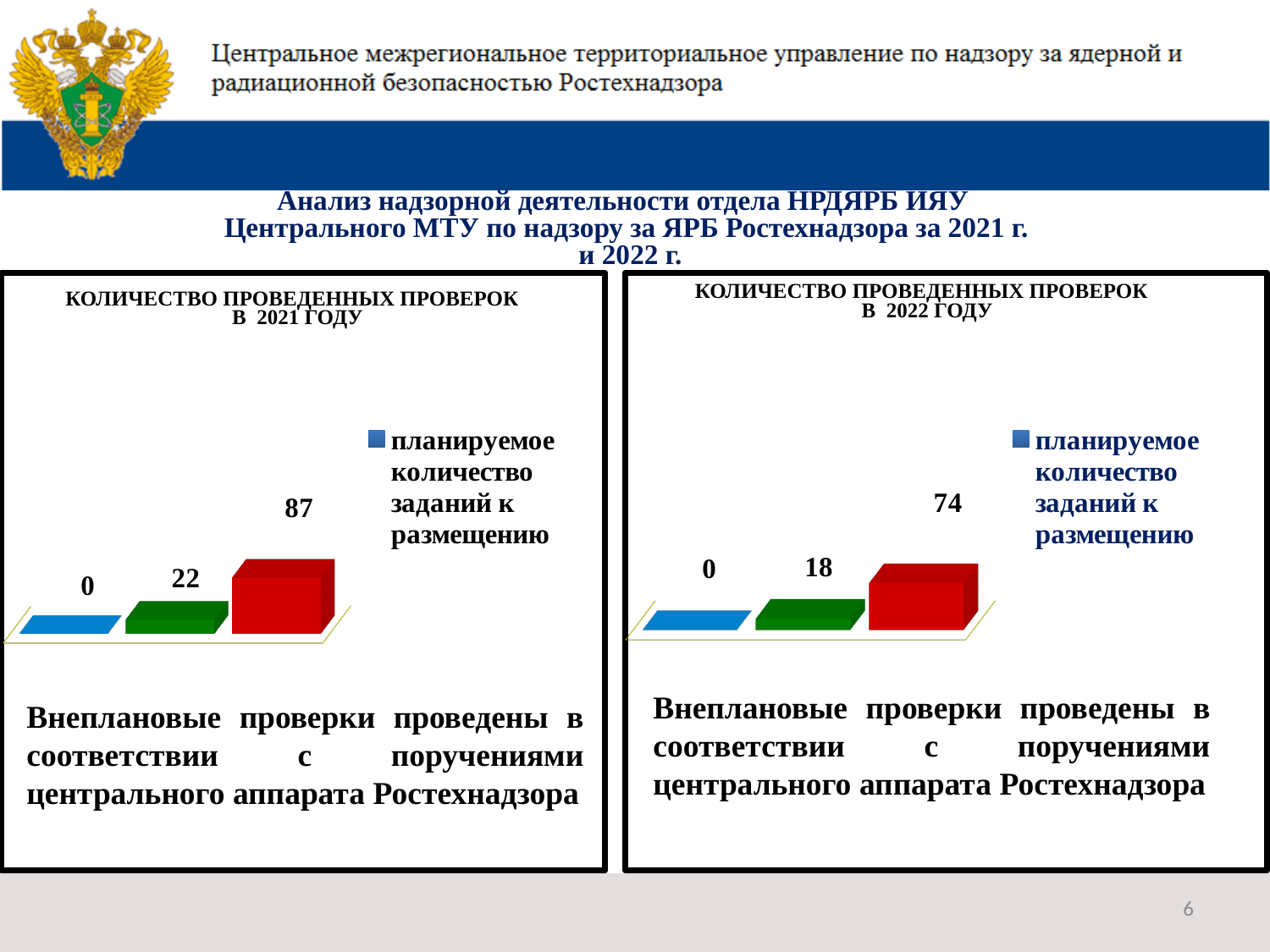
In the left chart (2021), what value is labelled on the blue bar? 0 In the left chart (2021), which bar has the highest value? The red bar (87) In the right chart (2022), what is the difference between the red bar and the green bar? 56 In the right chart (2022), what value is labelled on the blue bar? 0 In the chart titled "КОЛИЧЕСТВО ПРОВЕДЕННЫХ ПРОВЕРОК В 2022 ГОДУ" (right), what value is labelled on the red bar? 74 In the right chart (2022), what value is labelled on the green bar? 18 Which chart has the larger value for its red bar, the 2021 chart or the 2022 chart? The 2021 chart (87) In the left chart (2021), what value is labelled on the green bar? 22 How many bars are plotted in the left chart (2021)? 3 In the left chart (2021), what is the difference between the red bar and the green bar? 65 In the chart titled "КОЛИЧЕСТВО ПРОВЕДЕННЫХ ПРОВЕРОК В 2021 ГОДУ" (left), what value is labelled on the red bar? 87 What kind of chart is used in the right chart (2022)? Bar chart